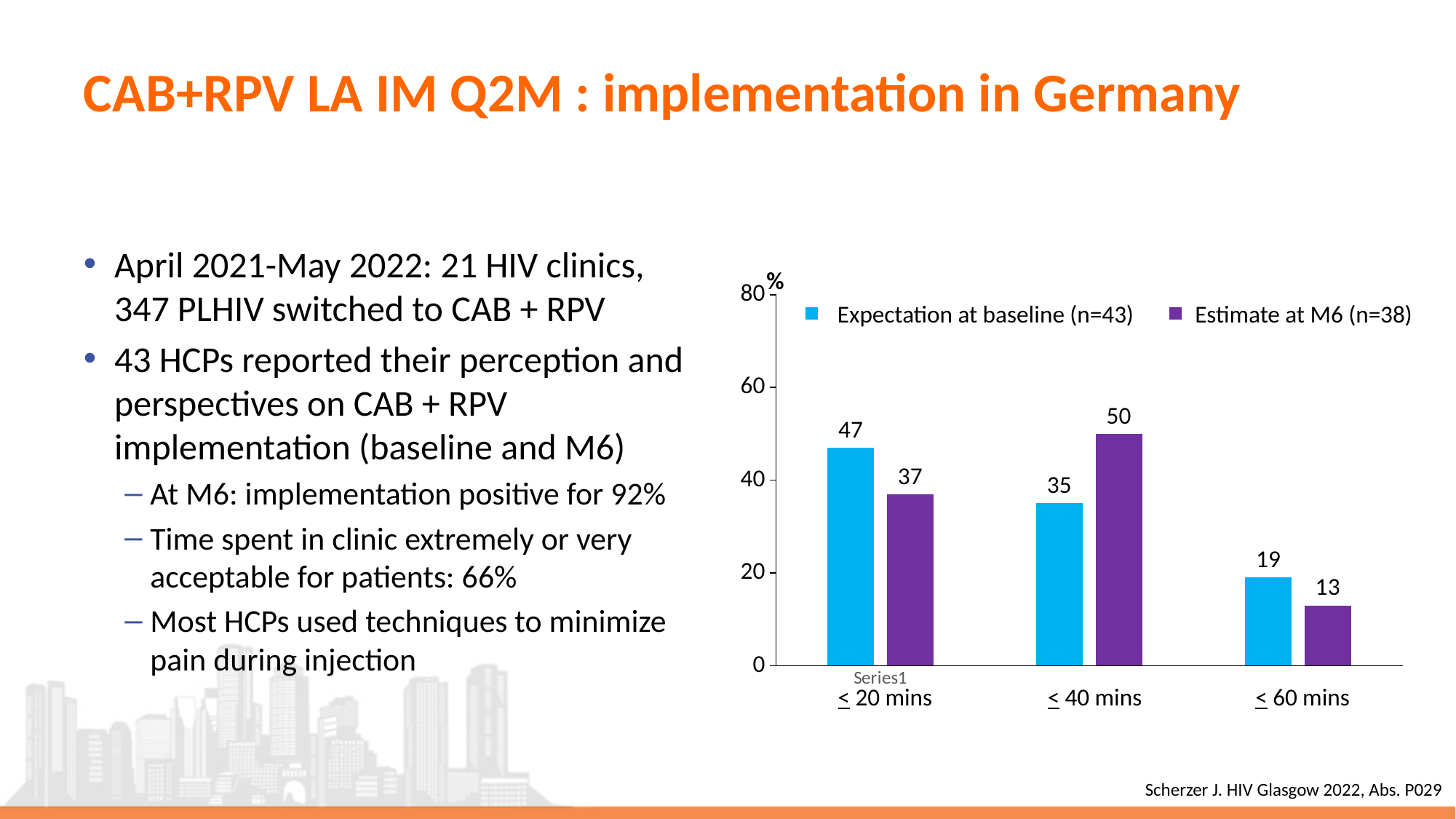
What is the value for Estimate at M6 (n=38) in the ≤ 60 mins category? 13 Is the value for Estimate at M6 (n=38) in the ≤ 20 mins category greater or less than 40? less In the ≤ 20 mins category, which is larger: Expectation at baseline (n=43) or Estimate at M6 (n=38)? Expectation at baseline (n=43) What colour are the bars for Estimate at M6 (n=38)? purple How many categories are shown on the x axis of the chart? 3 What is the difference between Expectation at baseline (n=43) and Estimate at M6 (n=38) in the ≤ 40 mins category? 15 Which category has the lowest value for Estimate at M6 (n=38)? ≤ 60 mins What is the value for Expectation at baseline (n=43) in the ≤ 20 mins category? 47 What kind of chart is shown on the slide? bar chart How many series does the chart legend list? 2 Which category has the highest value for Expectation at baseline (n=43)? ≤ 20 mins What is the value for Estimate at M6 (n=38) in the ≤ 40 mins category? 50